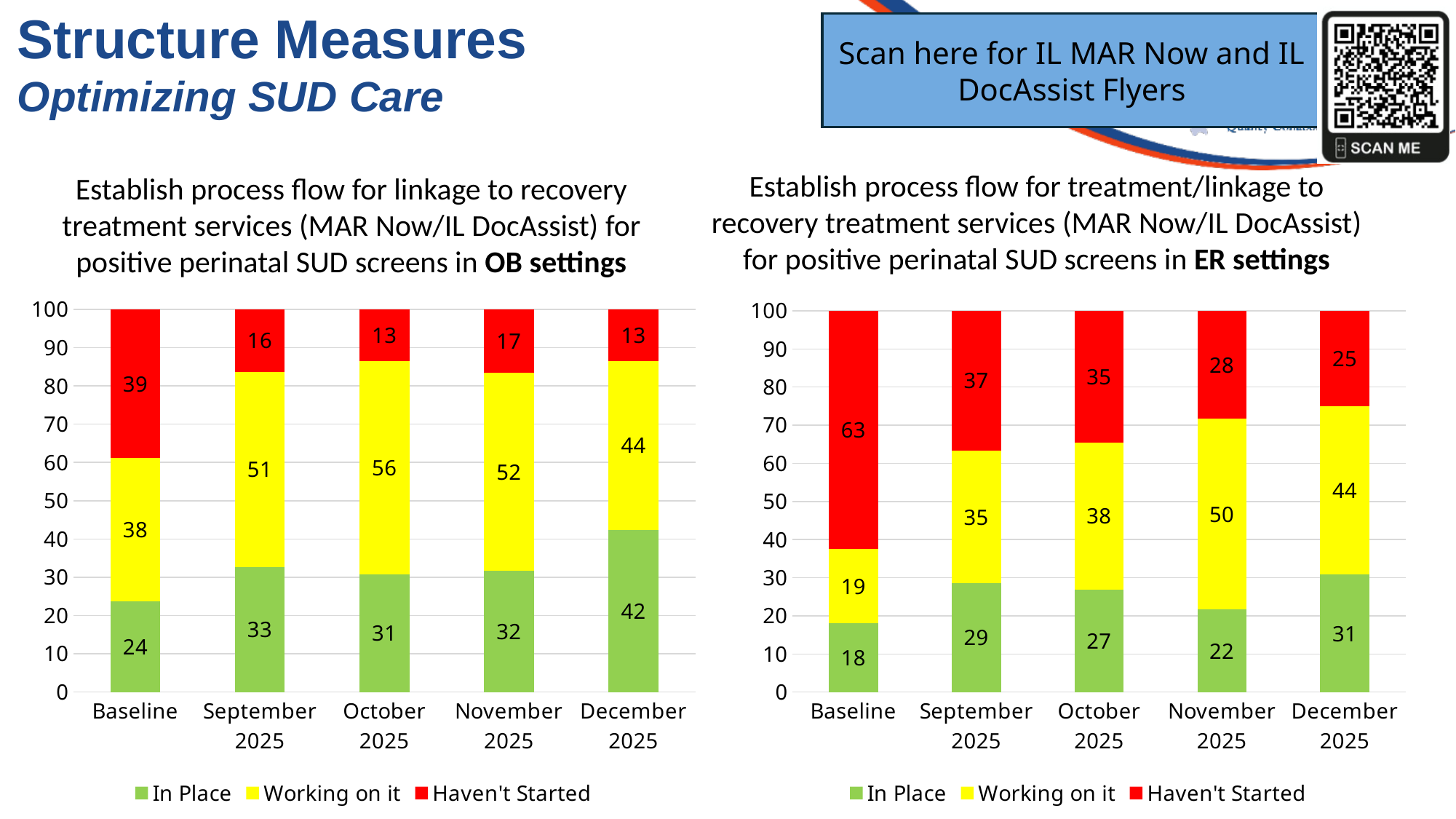
In the ER settings chart, what is the 'Working on it' value for November 2025? 50 In the ER settings chart, which category has the lowest 'In Place' value? Baseline In the OB settings chart, what is the 'In Place' value for December 2025? 42 In the OB settings chart, is the 'Working on it' value larger for September 2025 or November 2025? November 2025 How many categories are shown on the x axis of the ER settings chart? 5 In the ER settings chart, does the 'Haven't Started' value rise or fall from Baseline to December 2025? Fall In the OB settings chart, what is the 'Working on it' value for October 2025? 56 What kind of chart is the ER settings chart? Stacked bar chart In the ER settings chart, what is the 'Haven't Started' value at Baseline? 63 In the ER settings chart, what is the difference between the 'Haven't Started' values at Baseline and December 2025? 38 How many series does the legend of the OB settings chart list? 3 In the OB settings chart, which category has the highest 'In Place' value? December 2025